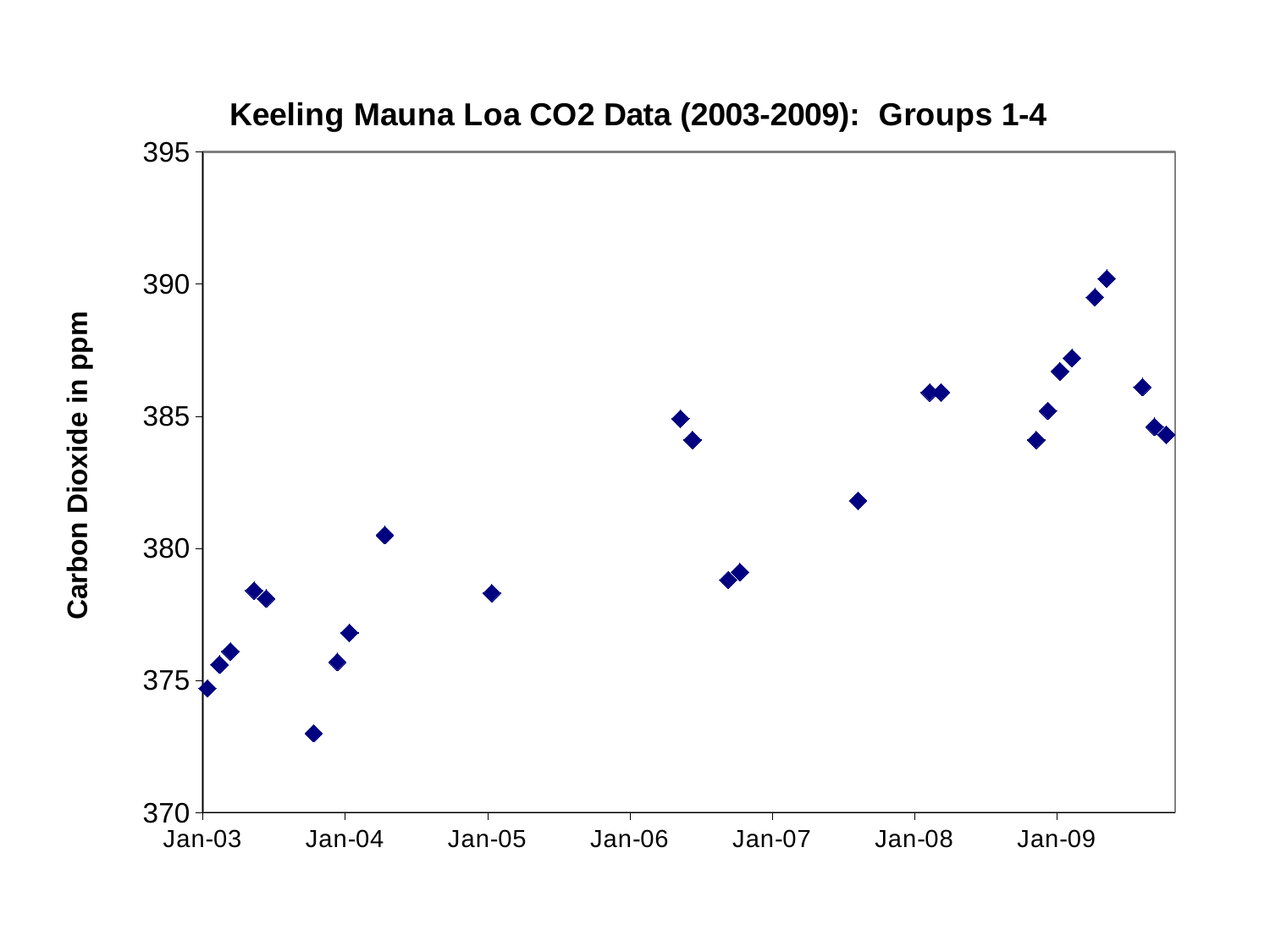
What is the label of the vertical axis? Carbon Dioxide in ppm Is the CO2 value plotted in mid-2007 greater or less than 380 ppm? greater What kind of chart is shown on the slide? scatter chart Do the CO2 values generally rise or fall from Jan-03 to Jan-09? rise Is the CO2 value plotted at Jan-05 greater or less than 380 ppm? less Is the highest plotted CO2 value greater or less than 385 ppm? greater In which year does the lowest CO2 value on the chart occur? 2003 What is the title of the chart? Keeling Mauna Loa CO2 Data (2003-2009): Groups 1-4 In which year does the highest CO2 value on the chart occur? 2009 Which is larger: the CO2 value plotted at Jan-05 or the value plotted in mid-2007? mid-2007